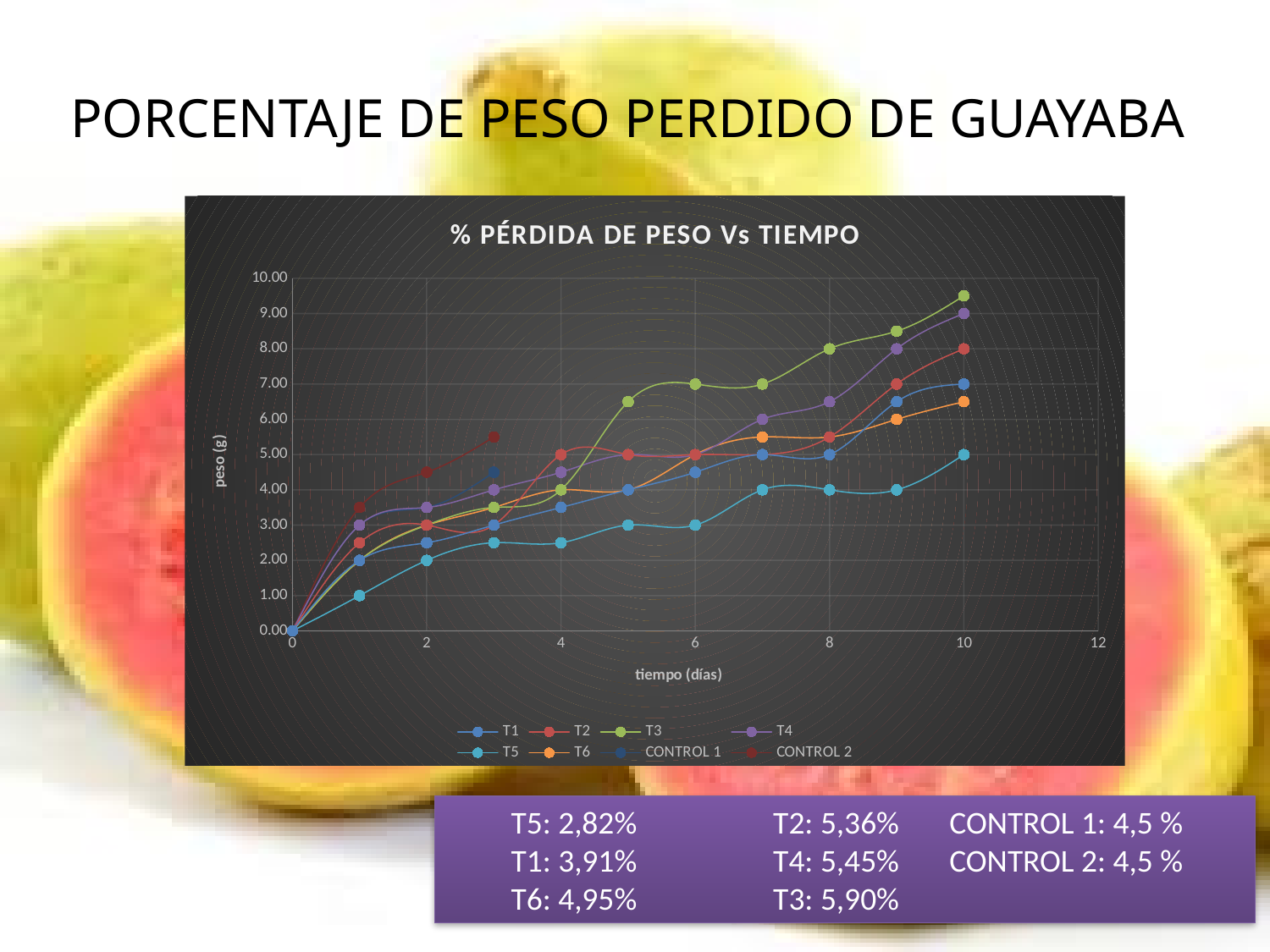
What is the label of the x axis of the chart? tiempo (días) What is the value for T4 at day 10? 9.00 What is the title of the chart? % PÉRDIDA DE PESO Vs TIEMPO At day 10, which series has the larger value, T2 or T1? T2 Is the value for T3 at day 10 greater or less than 9.00? greater How many data points are plotted for the CONTROL 2 series? 4 How many series does the chart legend list? 8 Which series has the lowest value at day 10? T5 Is the value for T5 at day 1 greater or less than 2.00? less Which series has the highest value at day 10? T3 What kind of chart is shown on the slide? line chart Do the values for T3 rise or fall as time increases from day 0 to day 10? rise